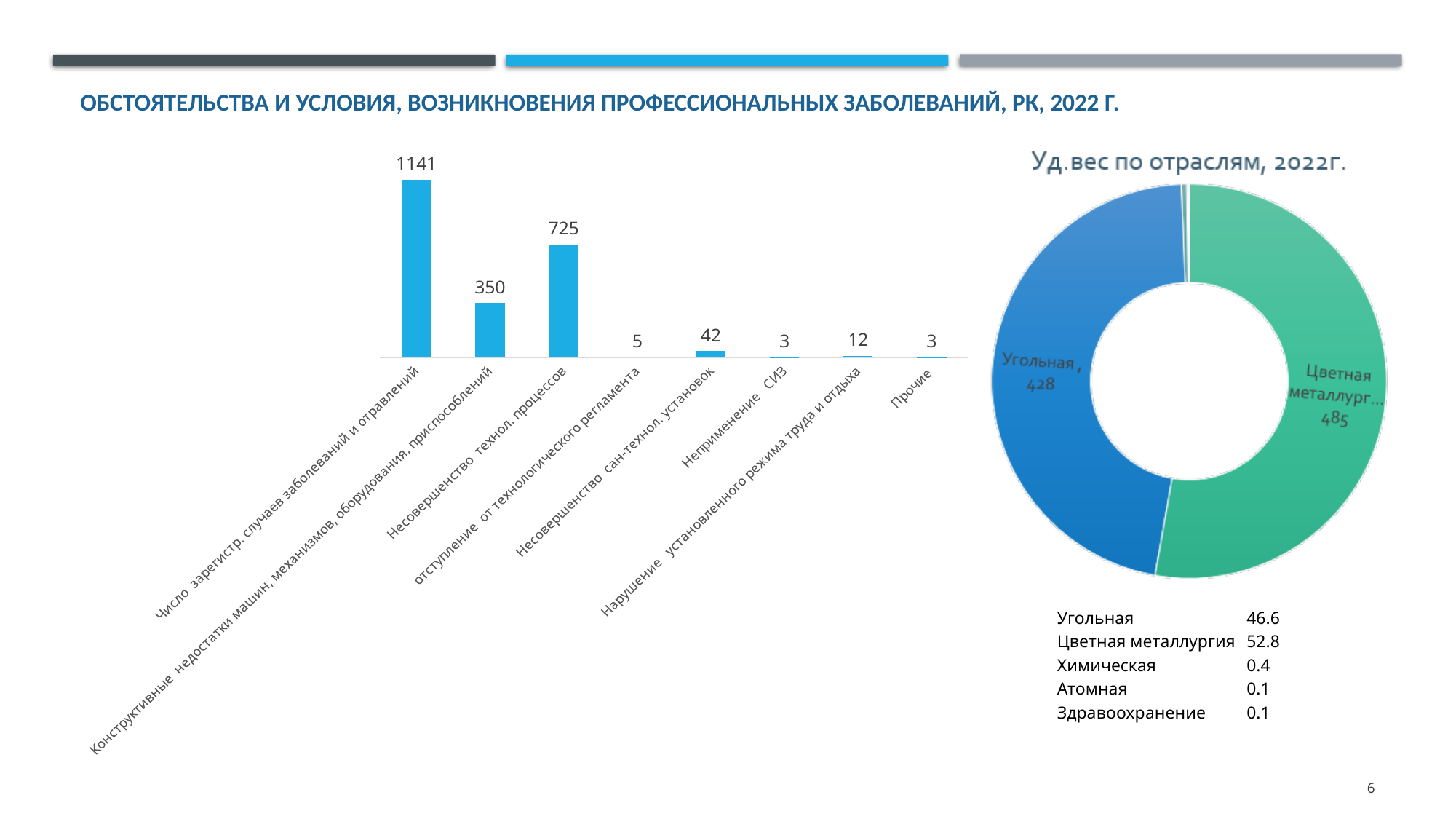
In the bar chart on the left, which is larger: «Несовершенство сан-технол. установок» or «отступление от технологического регламента»? Несовершенство сан-технол. установок In the bar chart on the left, what is the value for «Несовершенство технол. процессов»? 725 What type of chart is on the left side of the slide? Bar chart How many categories are shown in the bar chart on the left? 8 In the bar chart on the left, what is the value for «Нарушение установленного режима труда и отдыха»? 12 In the bar chart on the left, what is the value for «Несовершенство сан-технол. установок»? 42 In the bar chart on the left, which category has the highest value? Число зарегистр. случаев заболеваний и отравлений In the chart «Уд.вес по отраслям, 2022г.», which is larger: «Угольная» or «Цветная металлургия»? Цветная металлургия In the bar chart on the left, what is the value for «Конструктивные недостатки машин, механизмов, оборудования, приспособлений»? 350 In the bar chart on the left, what is the difference between «Несовершенство технол. процессов» and «Конструктивные недостатки машин, механизмов, оборудования, приспособлений»? 375 In the chart «Уд.вес по отраслям, 2022г.», what value is shown for «Угольная»? 428 What is the title of the chart on the right side of the slide? Уд.вес по отраслям, 2022г.